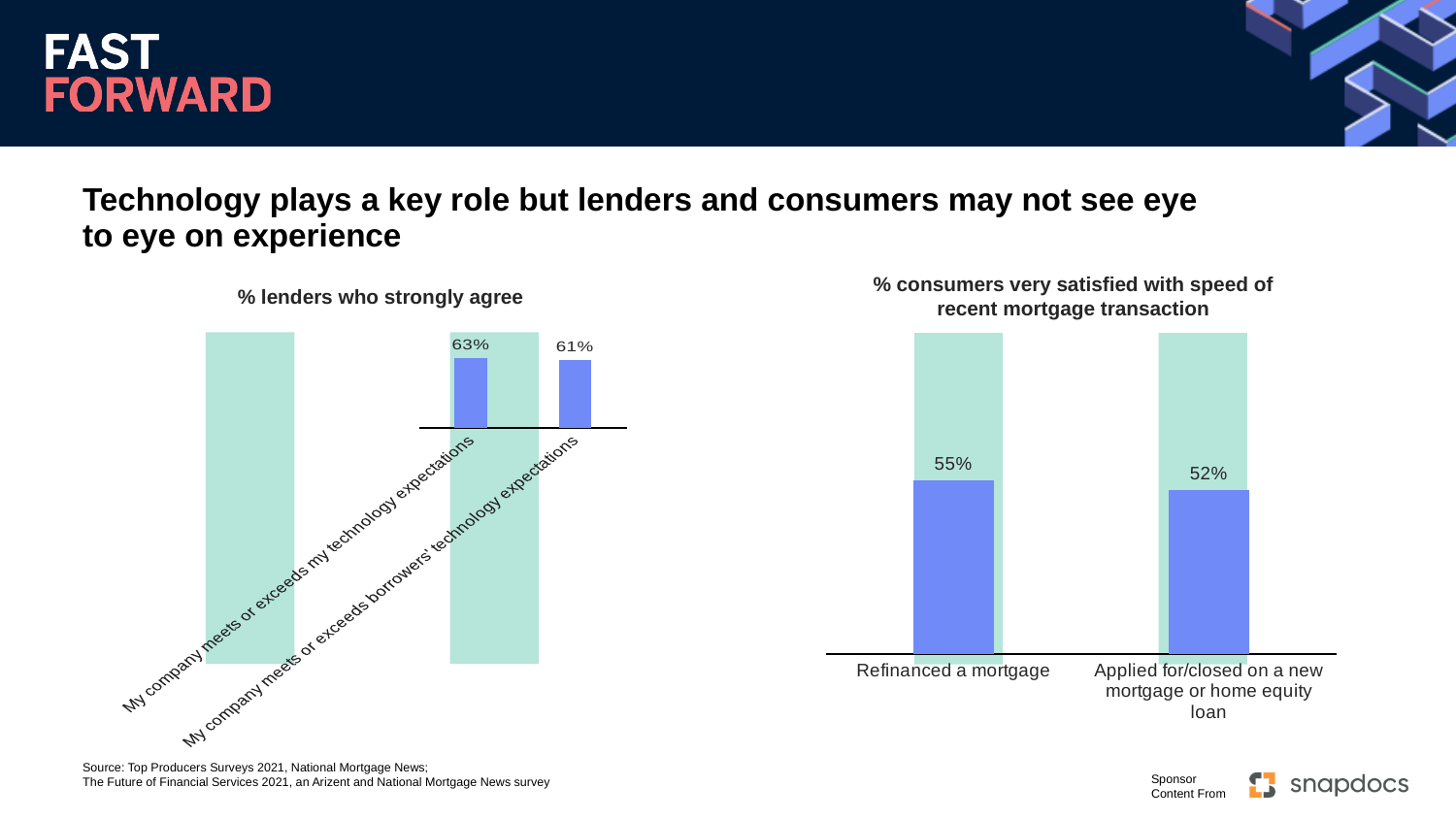
In the '% lenders who strongly agree' chart, what is the difference between the two bars? 2% In the '% consumers very satisfied with speed of recent mortgage transaction' chart, what is the difference between 'Refinanced a mortgage' and 'Applied for/closed on a new mortgage or home equity loan'? 3% What kind of chart is the '% consumers very satisfied with speed of recent mortgage transaction' chart? bar chart What is the title of the chart on the left side of the slide? % lenders who strongly agree In the '% lenders who strongly agree' chart, which category has the higher value? My company meets or exceeds my technology expectations In the '% consumers very satisfied with speed of recent mortgage transaction' chart, what is the value for 'Refinanced a mortgage'? 55% In the '% lenders who strongly agree' chart, how many bars are plotted? 2 In the '% consumers very satisfied with speed of recent mortgage transaction' chart, which category has the lower value? Applied for/closed on a new mortgage or home equity loan In the '% lenders who strongly agree' chart, what is the value for 'My company meets or exceeds borrowers' technology expectations'? 61% In the '% consumers very satisfied with speed of recent mortgage transaction' chart, what is the value for 'Applied for/closed on a new mortgage or home equity loan'? 52% Is the value for 'Refinanced a mortgage' in the right-hand chart larger or smaller than the value for 'My company meets or exceeds my technology expectations' in the left-hand chart? smaller In the '% lenders who strongly agree' chart, what is the value for 'My company meets or exceeds my technology expectations'? 63%